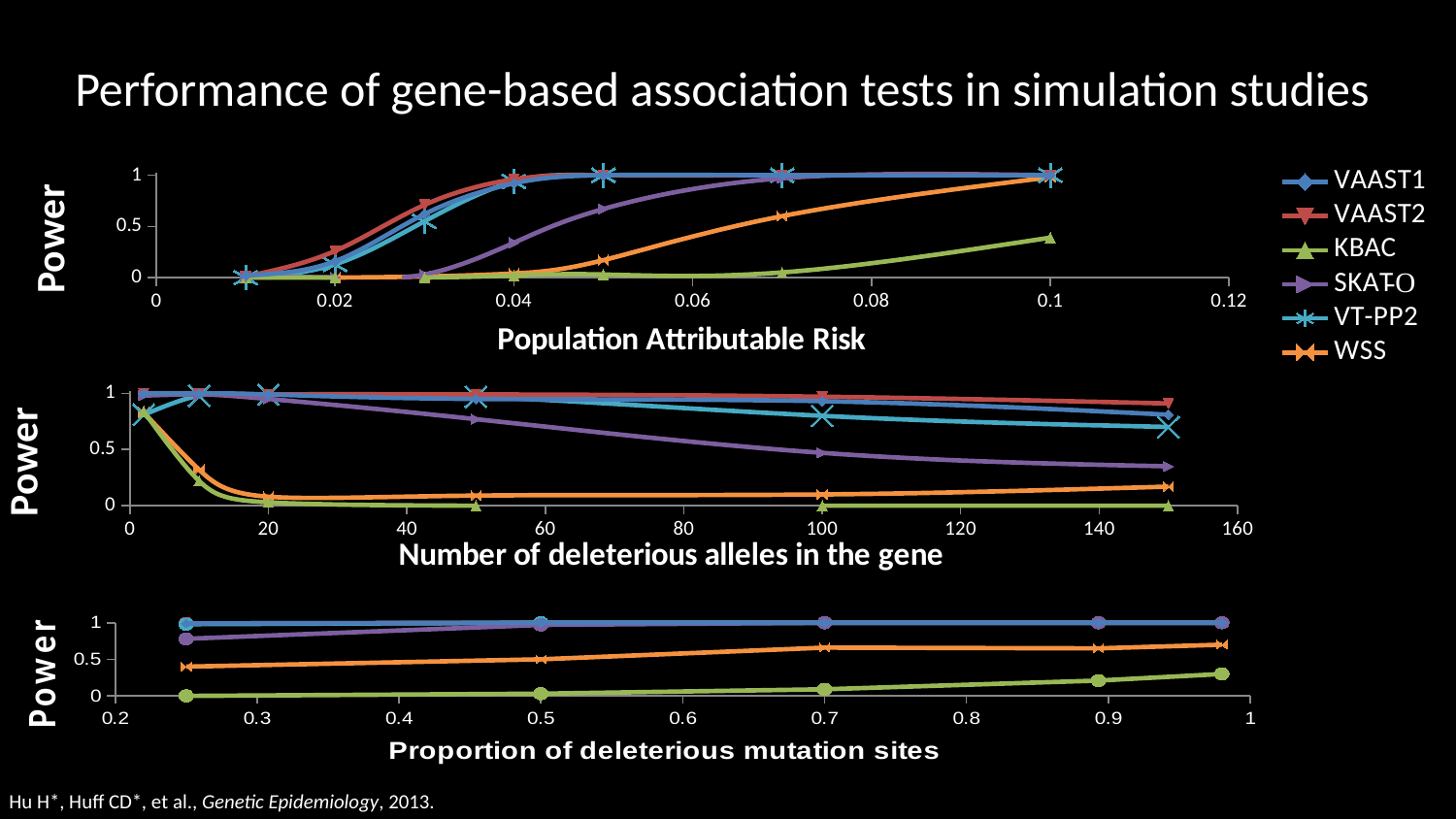
In the middle chart (Number of deleterious alleles in the gene), is the value for SKAT-O at 150 greater or less than 0.5? less In the top chart (Population Attributable Risk), does the power for KBAC rise or fall as Population Attributable Risk increases? rise What kind of chart is the top chart, with x axis 'Population Attributable Risk'? line chart In the top chart (Population Attributable Risk), is the value for KBAC at 0.1 greater or less than 0.5? less In the middle chart (Number of deleterious alleles in the gene), which is larger at 150: VAAST2 or KBAC? VAAST2 In the top chart (Population Attributable Risk), is the value for WSS at 0.07 greater or less than 0.5? greater In the top chart (Population Attributable Risk), which series has the lowest power at 0.1? KBAC What is the x-axis title of the bottom chart? Proportion of deleterious mutation sites How many series does the legend on the slide list? 6 In the bottom chart (Proportion of deleterious mutation sites), how many data points does each line have? 5 In the middle chart (Number of deleterious alleles in the gene), which series has the highest power at 150? VAAST2 In the middle chart (Number of deleterious alleles in the gene), does the power for SKAT-O rise or fall as the number of alleles increases? fall